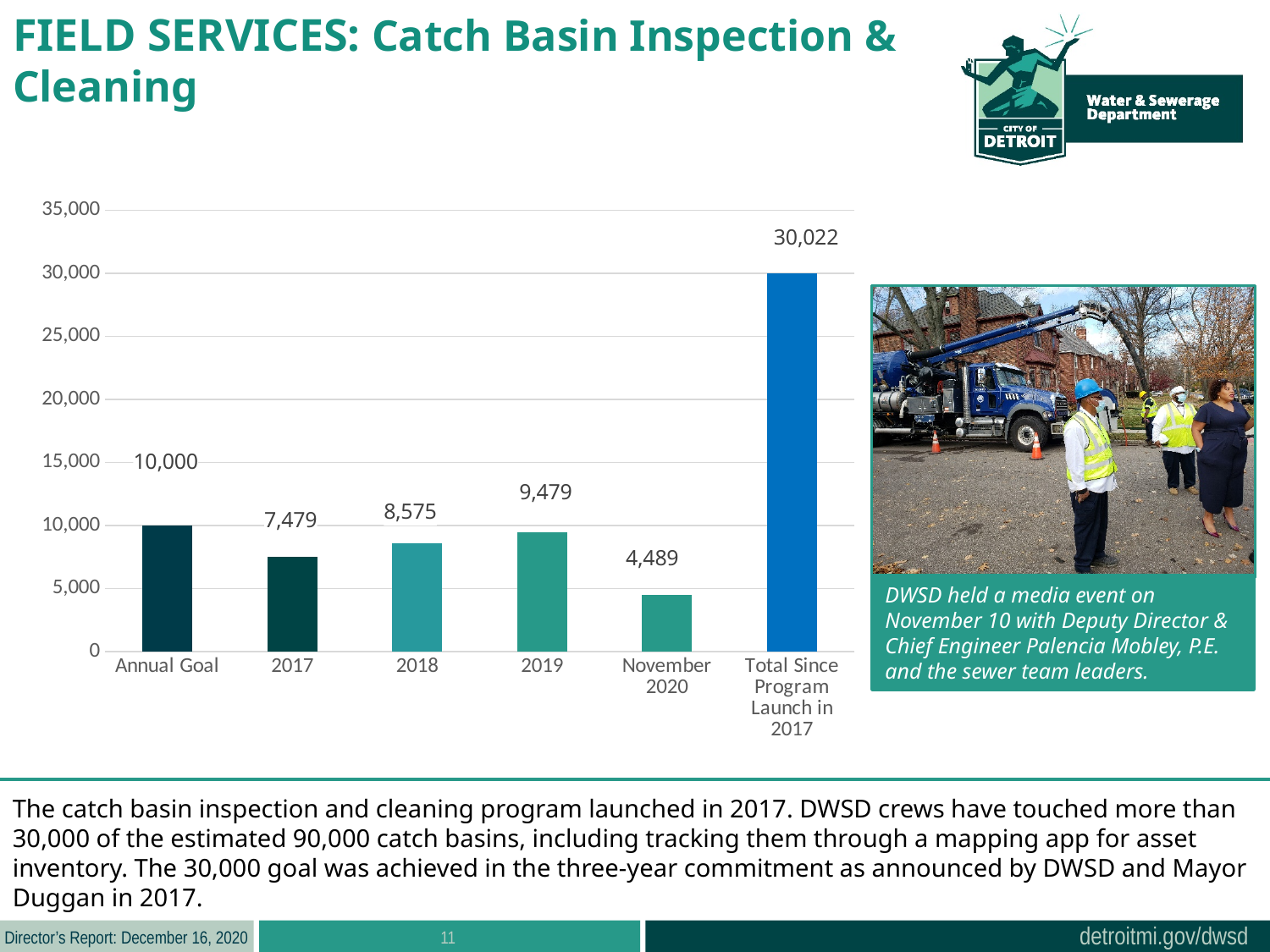
Which category has the lowest value? November 2020 How many bars are shown in the chart? 6 What is the value for 2018? 8,575 What is the value for November 2020? 4,489 Is the value for 2017 greater or less than 10,000? less Which is larger, the value for 2018 or the value for 2019? 2019 What is the value for Annual Goal? 10,000 Do the values rise or fall from 2017 to 2019? rise What is the value for Total Since Program Launch in 2017? 30,022 Which category has the highest value? Total Since Program Launch in 2017 What kind of chart is shown on the slide? bar chart What is the difference between the values for 2019 and 2017? 2,000